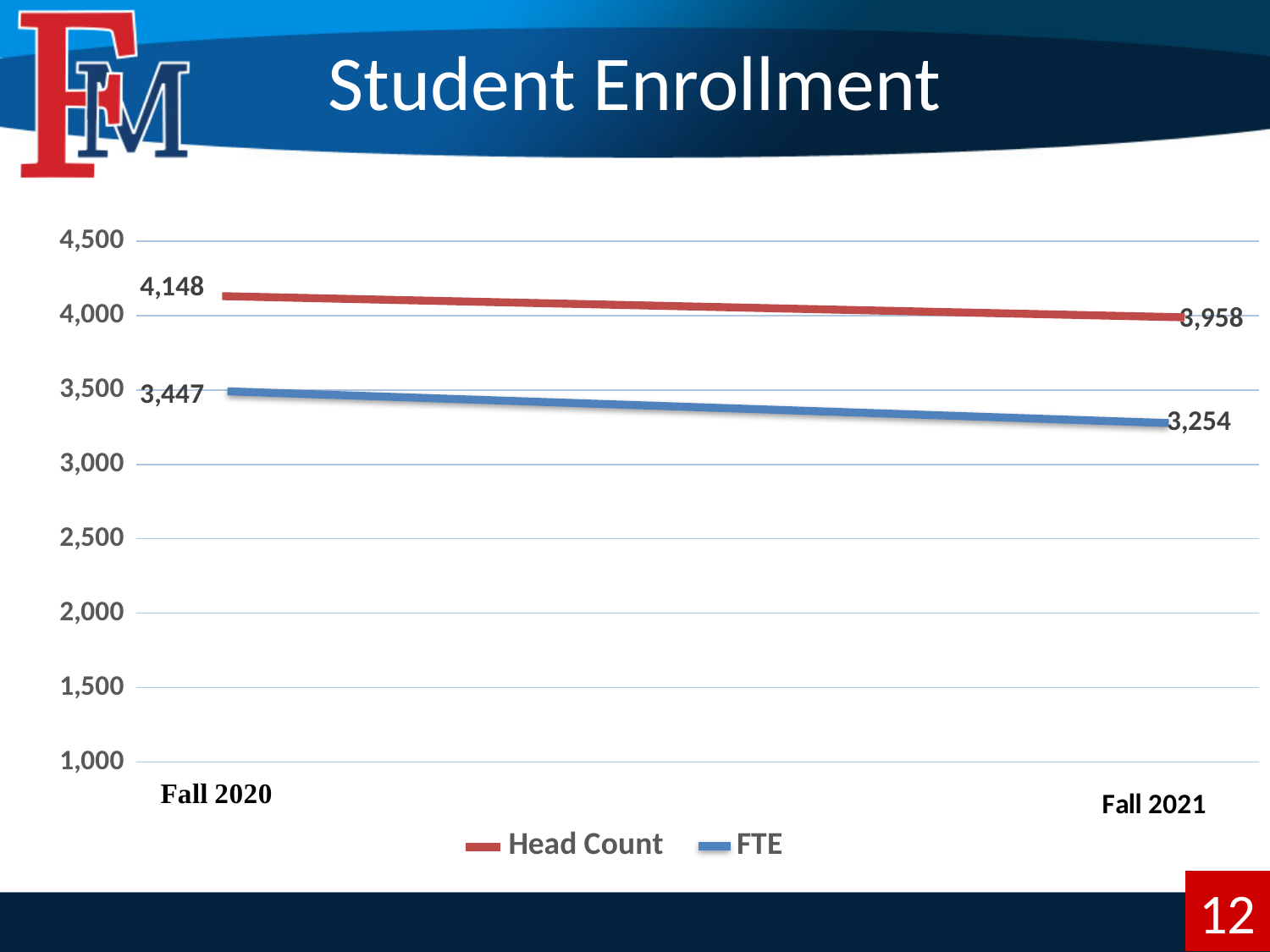
What is the Head Count for Fall 2020? 4,148 By how much did the FTE change from Fall 2020 to Fall 2021? 193 What is the Head Count for Fall 2021? 3,958 What is the FTE for Fall 2020? 3,447 Which is larger in Fall 2021, Head Count or FTE? Head Count What is the title of the slide containing the chart? Student Enrollment What kind of chart is shown on the slide? line chart By how much did the Head Count change from Fall 2020 to Fall 2021? 190 How many series does the legend list? 2 Does the FTE rise or fall from Fall 2020 to Fall 2021? fall What is the FTE for Fall 2021? 3,254 Does the Head Count rise or fall from Fall 2020 to Fall 2021? fall